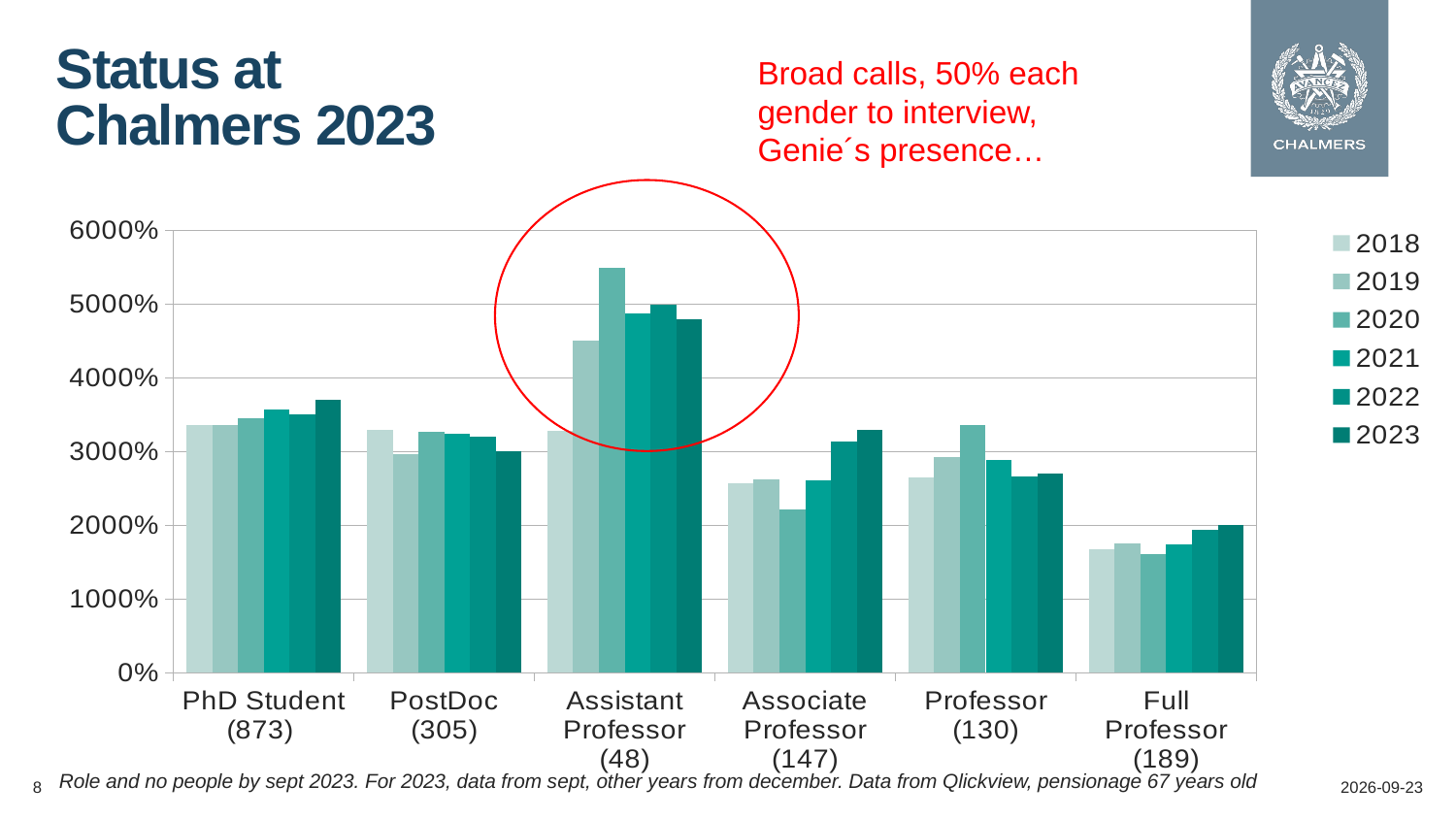
What is the title of the slide containing the chart? Status at Chalmers 2023 Is the value for Associate Professor in 2020 greater or less than 3000%? less Is the value for Full Professor in 2018 greater or less than 2000%? less Which category has the highest value for 2020? Assistant Professor How many series does the legend list? 6 How many categories are shown on the x axis of the chart? 6 Is the value for Assistant Professor in 2020 greater or less than 5000%? greater Which is larger for Professor, the 2020 value or the 2023 value? 2020 Which is larger, the 2019 value for Assistant Professor or the 2019 value for PhD Student? Assistant Professor Which category has the lowest value for 2023? Full Professor What kind of chart is shown on the slide? bar chart Do the Full Professor bars rise or fall from 2020 to 2023? rise